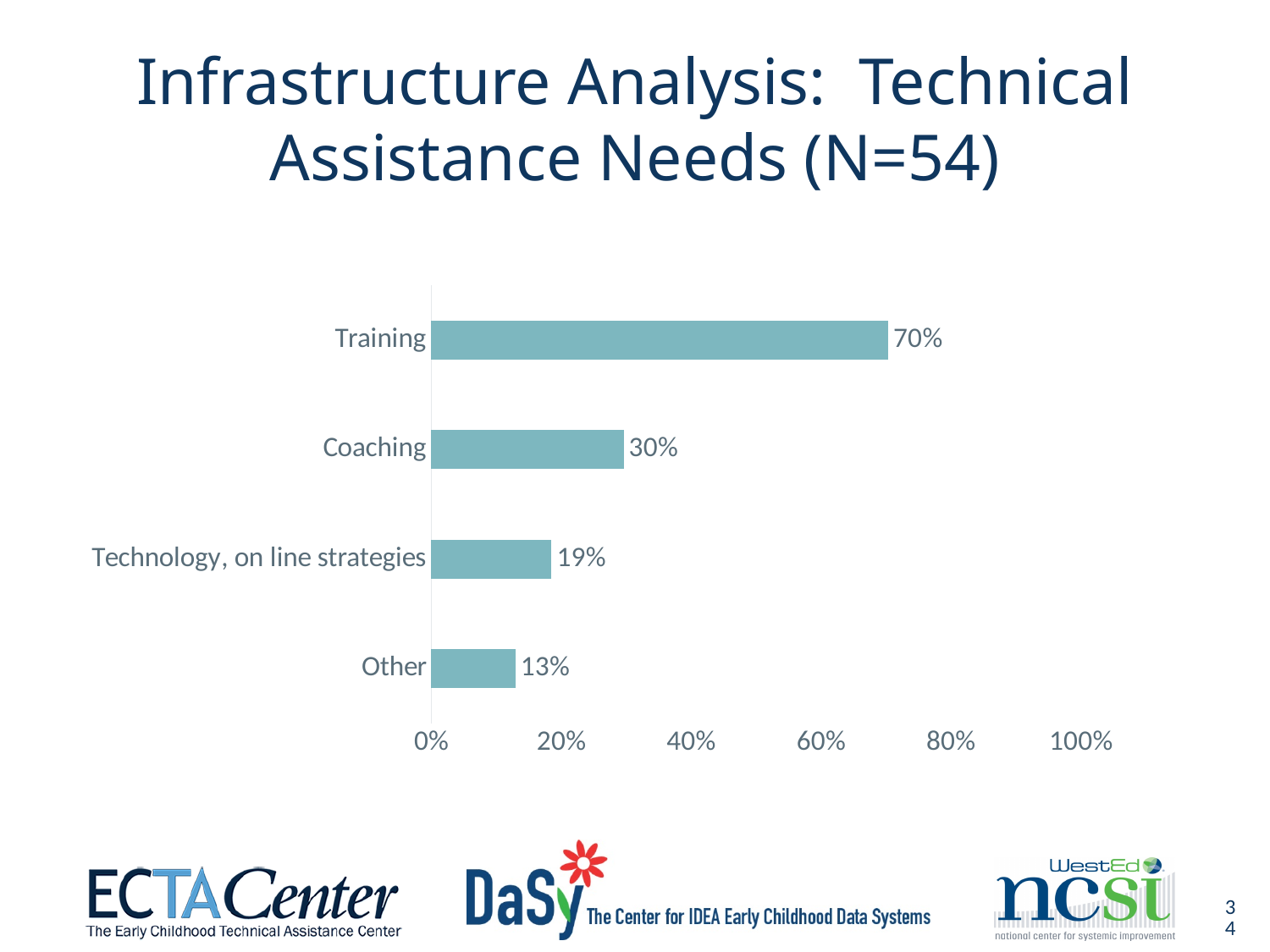
What is the difference between the values for Training and Coaching? 40% Which category has the lowest value? Other What is the value for Coaching? 30% What is the difference between the values for Technology, on line strategies and Other? 6% Which category has the highest value? Training What is the value for Other? 13% What is the value for Technology, on line strategies? 19% Which is larger, the value for Coaching or the value for Technology, on line strategies? Coaching What is the value for Training? 70% How many categories are shown in the chart? 4 Is the value for Training greater or less than 60%? greater What kind of chart is shown on the slide? bar chart